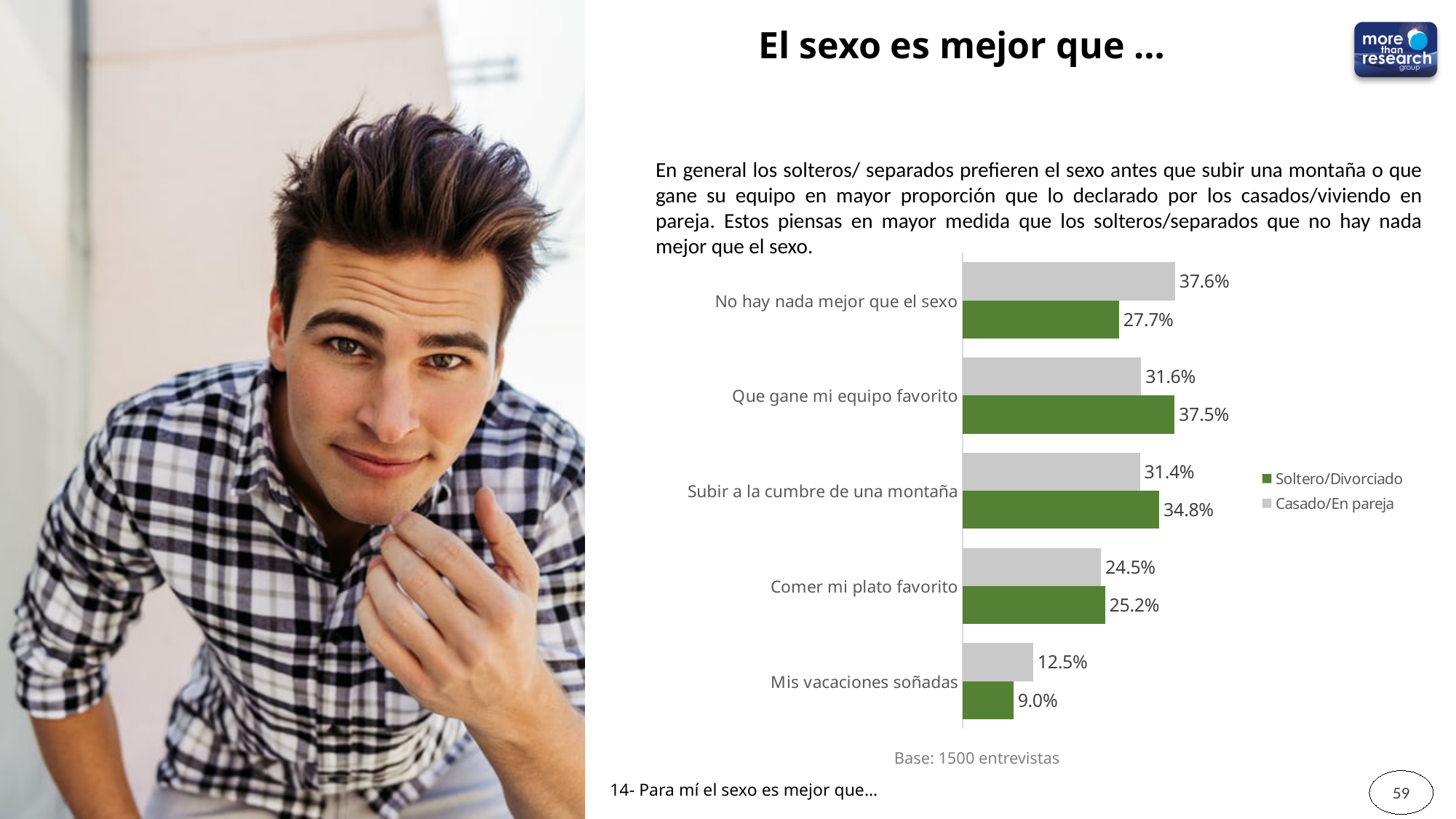
What kind of chart is shown on the slide? Bar chart How many categories are shown in the chart? 5 What is the value for Soltero/Divorciado for 'No hay nada mejor que el sexo'? 27.7% Which category has the highest value for Casado/En pareja? No hay nada mejor que el sexo Which category has the lowest value for Soltero/Divorciado? Mis vacaciones soñadas Which colour represents the Soltero/Divorciado series? Green For 'Mis vacaciones soñadas', which series has the larger value: Soltero/Divorciado or Casado/En pareja? Casado/En pareja What is the value for Casado/En pareja for 'Que gane mi equipo favorito'? 31.6% How many series does the legend list? 2 For 'Que gane mi equipo favorito', which series has the larger value: Soltero/Divorciado or Casado/En pareja? Soltero/Divorciado What is the value for Soltero/Divorciado for 'Mis vacaciones soñadas'? 9.0% What is the difference between Casado/En pareja and Soltero/Divorciado for 'No hay nada mejor que el sexo'? 9.9%